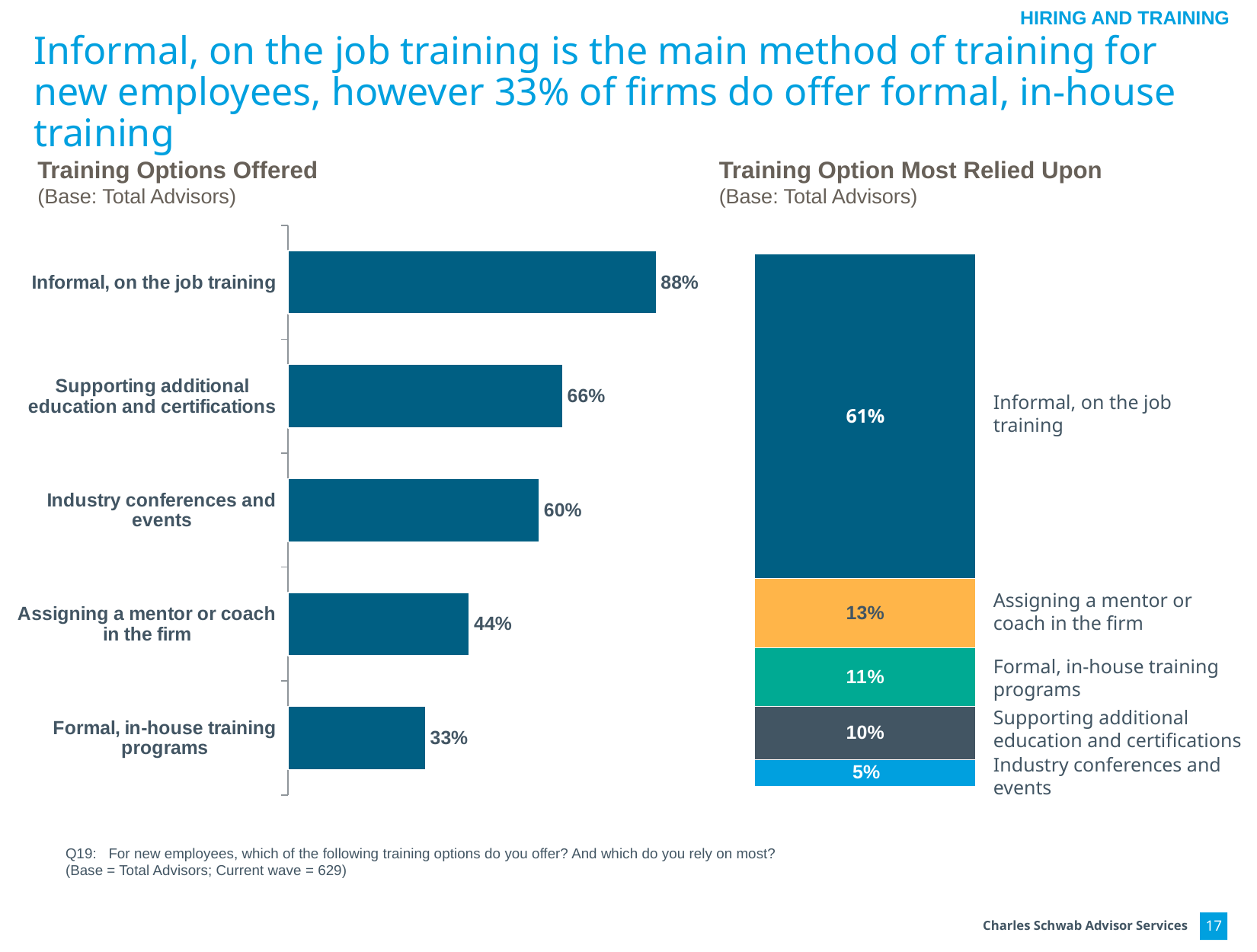
In the 'Training Option Most Relied Upon' chart, what is the total of all the stacked segments? 100% In the 'Training Option Most Relied Upon' chart, what colour is the segment for assigning a mentor or coach in the firm? Orange In the 'Training Options Offered' chart, which training option has the lowest value? Formal, in-house training programs In the 'Training Options Offered' chart, what percentage of advisors offer informal, on the job training? 88% In the 'Training Options Offered' chart, what is the difference between supporting additional education and certifications and industry conferences and events? 6% In the 'Training Option Most Relied Upon' chart, which is larger: formal, in-house training programs or supporting additional education and certifications? Formal, in-house training programs In the 'Training Options Offered' chart, how many training options are listed? 5 In the 'Training Options Offered' chart, what is the value for formal, in-house training programs? 33% In the 'Training Option Most Relied Upon' chart, which option has the smallest segment? Industry conferences and events What kind of chart is the 'Training Options Offered' chart? Bar chart In the 'Training Option Most Relied Upon' chart, what percentage of advisors rely most on assigning a mentor or coach in the firm? 13% In the 'Training Option Most Relied Upon' chart, how many segments make up the stacked bar? 5